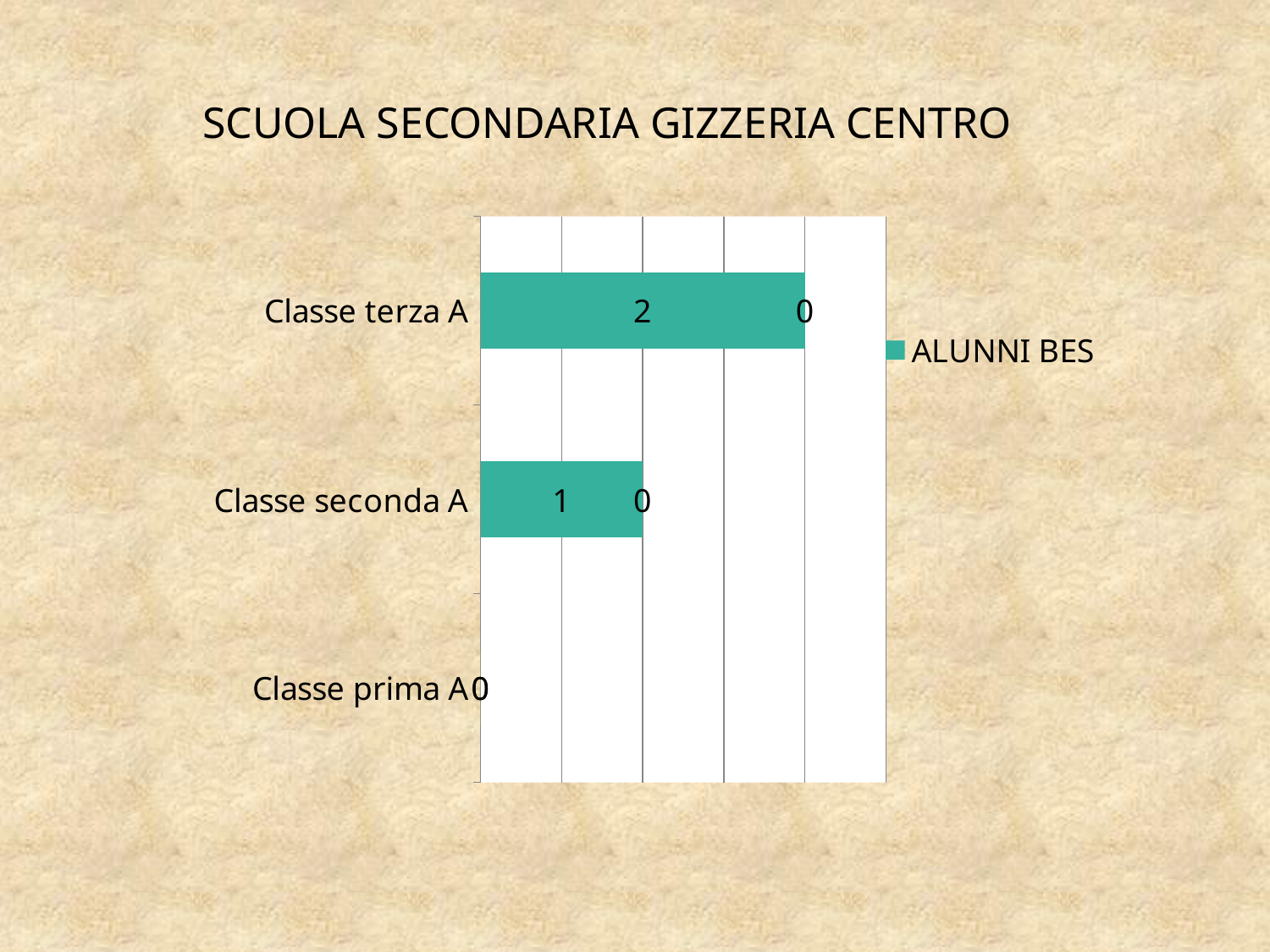
What series name is shown in the legend? ALUNNI BES Which has a larger ALUNNI BES value, Classe seconda A or Classe terza A? Classe terza A Which class has the highest ALUNNI BES value? Classe terza A What is the difference between the ALUNNI BES values for Classe terza A and Classe seconda A? 1 What kind of chart is shown on the slide? Bar chart How many series does the legend list? 1 What is the ALUNNI BES value for Classe seconda A? 1 What is the ALUNNI BES value for Classe terza A? 2 What is the title of the slide? SCUOLA SECONDARIA GIZZERIA CENTRO How many classes are shown on the chart? 3 Which class has the lowest ALUNNI BES value? Classe prima A What is the ALUNNI BES value for Classe prima A? 0